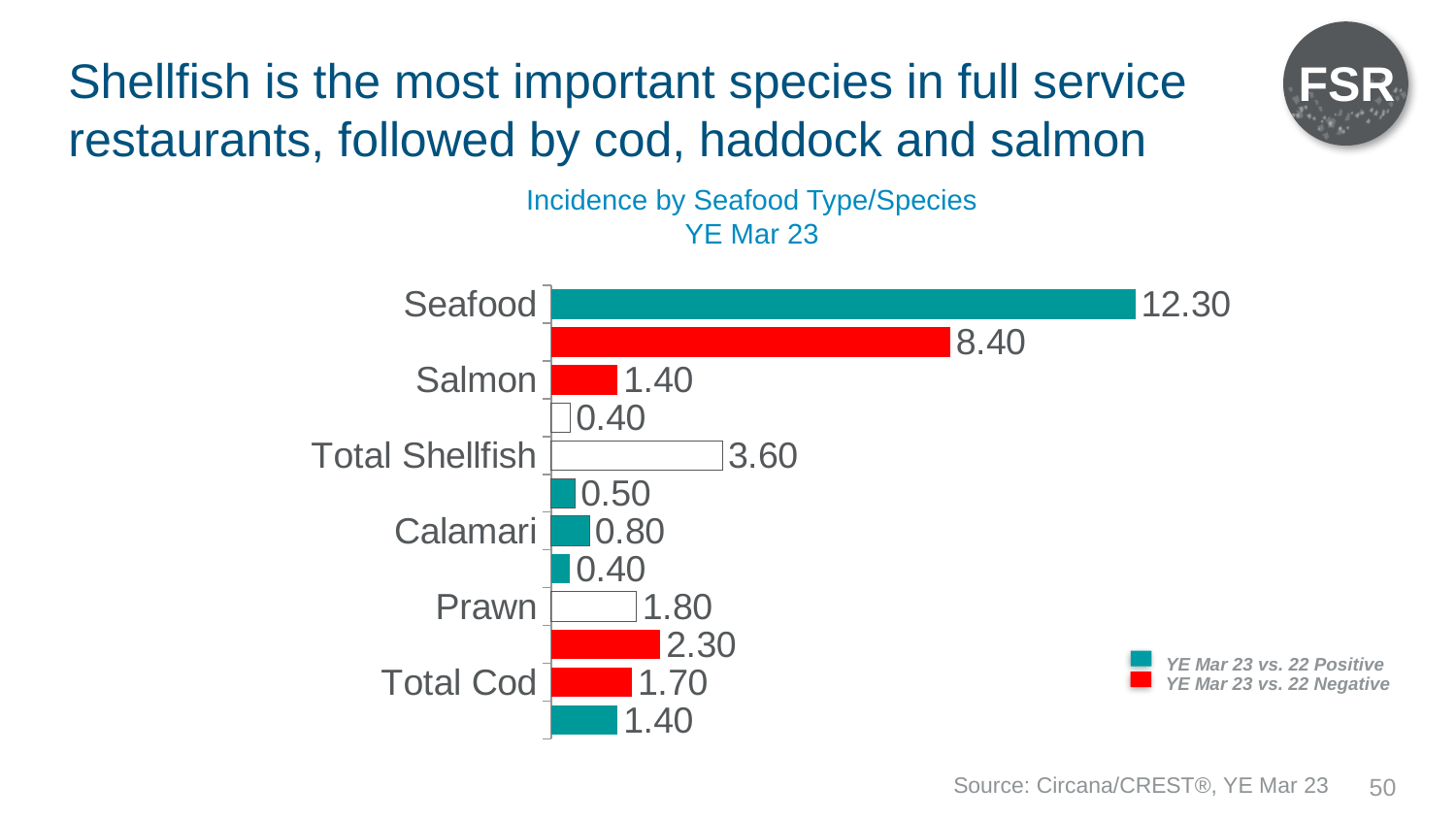
Which labelled category has the lowest value? Calamari What is the value for Prawn? 1.80 What is the value for Total Shellfish? 3.60 How many series does the legend list? 2 What is the difference between the values for Seafood and Total Shellfish? 8.70 What is the value for Calamari? 0.80 What is the value for Seafood? 12.30 What is the title of the chart? Incidence by Seafood Type/Species YE Mar 23 What is the value for Total Cod? 1.70 Which is larger, the value for Prawn or the value for Total Cod? Prawn What kind of chart is shown on the slide? Bar chart Which labelled category has the highest value? Seafood